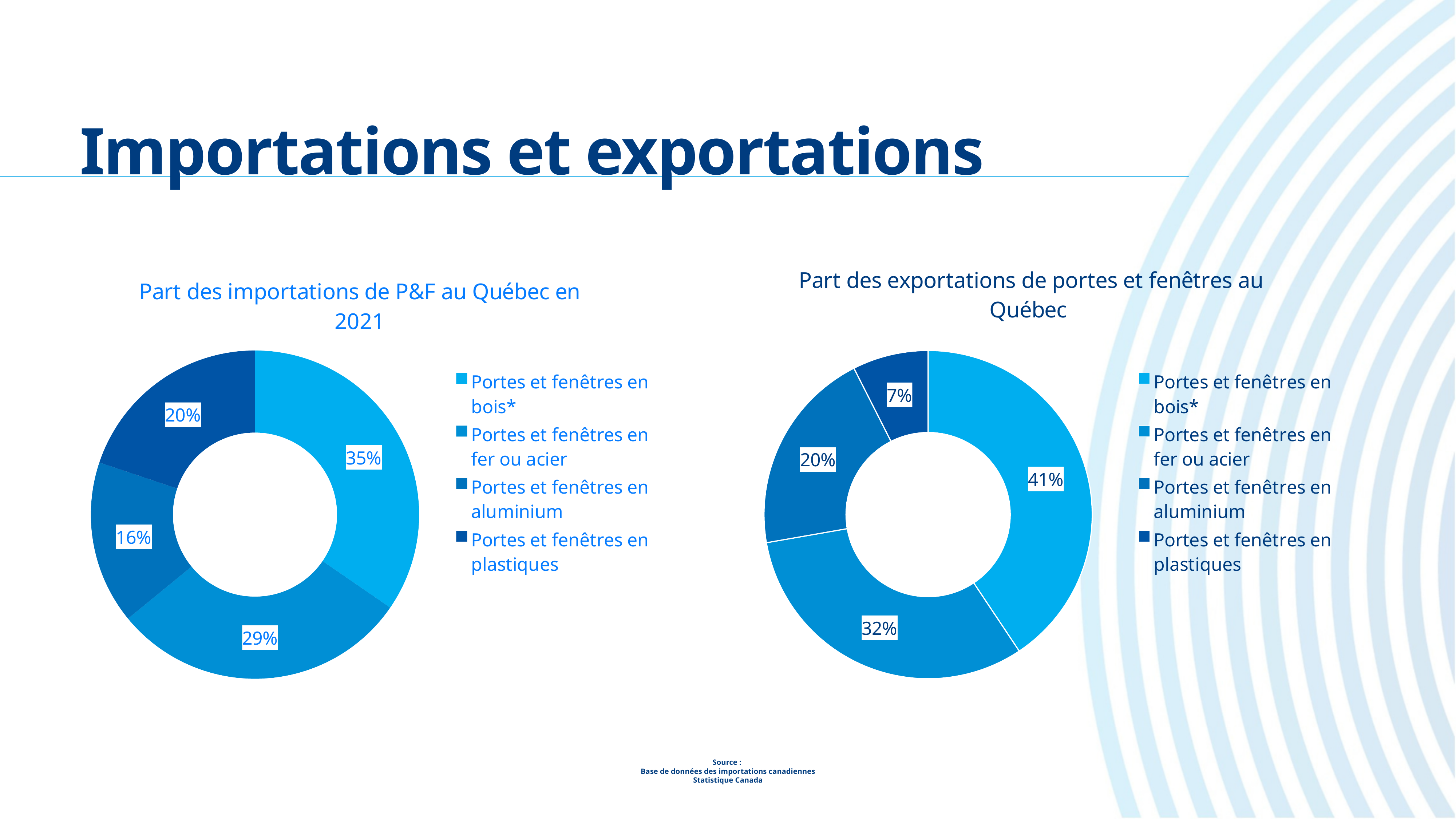
In the chart 'Part des exportations de portes et fenêtres au Québec', what is the difference in percentage points between Portes et fenêtres en bois* and Portes et fenêtres en fer ou acier? 9 percentage points In the chart 'Part des importations de P&F au Québec en 2021', what share is shown for Portes et fenêtres en bois*? 35% In the chart 'Part des importations de P&F au Québec en 2021', which category has the smallest share? Portes et fenêtres en aluminium How many entries does the legend of the chart 'Part des exportations de portes et fenêtres au Québec' list? 4 In the chart 'Part des exportations de portes et fenêtres au Québec', what share is shown for Portes et fenêtres en fer ou acier? 32% In the chart 'Part des importations de P&F au Québec en 2021', what share is shown for Portes et fenêtres en aluminium? 16% In the chart 'Part des importations de P&F au Québec en 2021', which category has the largest share? Portes et fenêtres en bois* What type of chart is 'Part des importations de P&F au Québec en 2021'? Doughnut chart In the chart 'Part des importations de P&F au Québec en 2021', which is larger: the share for Portes et fenêtres en plastiques or for Portes et fenêtres en aluminium? Portes et fenêtres en plastiques In the chart 'Part des exportations de portes et fenêtres au Québec', what share is shown for Portes et fenêtres en plastiques? 7% In the chart 'Part des exportations de portes et fenêtres au Québec', which category has the smallest share? Portes et fenêtres en plastiques How many categories does the chart 'Part des exportations de portes et fenêtres au Québec' show? 4